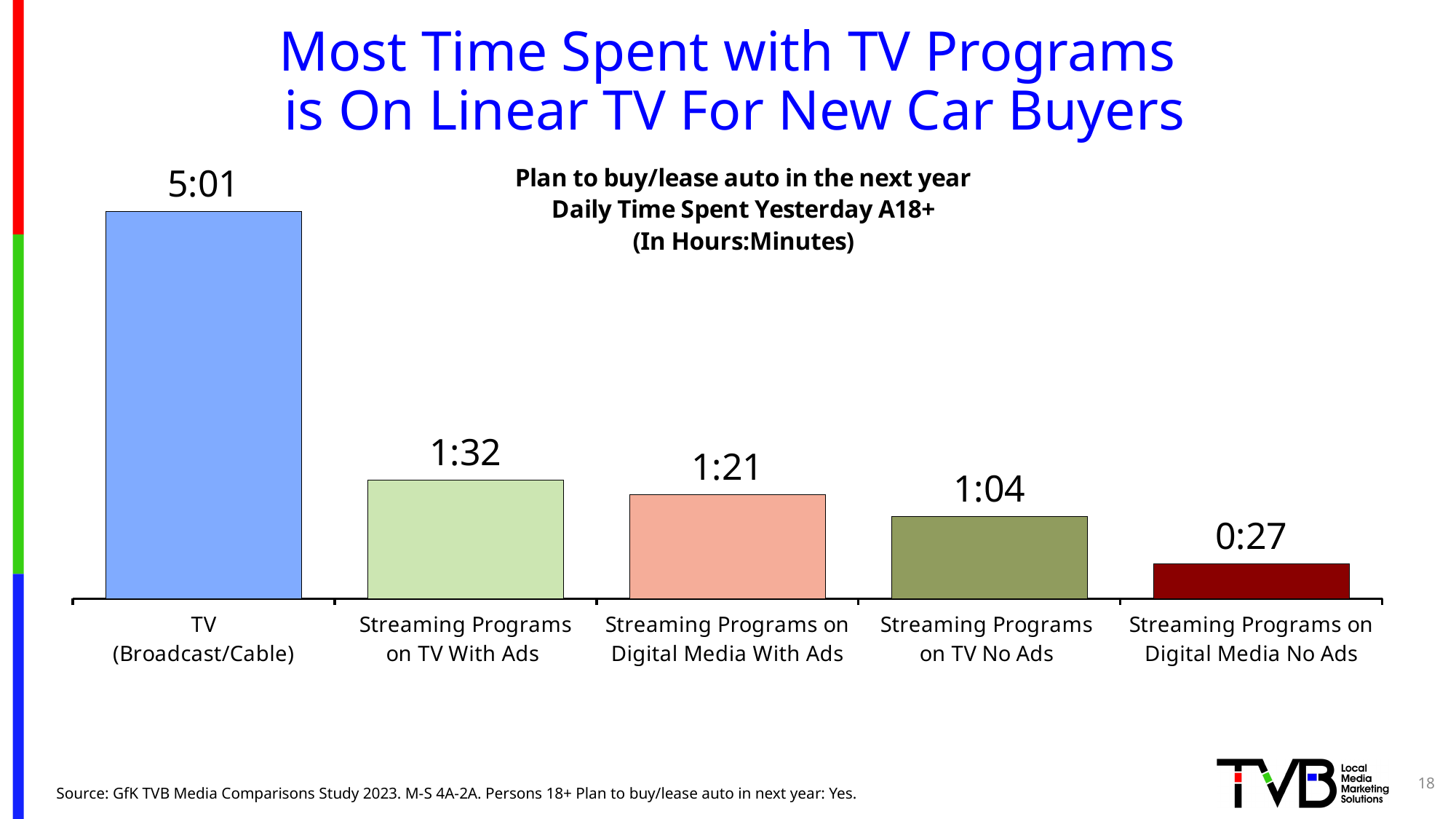
How many categories are shown in the chart? 5 What is the daily time spent with Streaming Programs on TV No Ads? 1:04 What is the daily time spent with TV (Broadcast/Cable)? 5:01 Which category has the lowest daily time spent? Streaming Programs on Digital Media No Ads What type of chart is shown on the slide? Bar chart In what units are the chart values expressed, according to the chart title? Hours:Minutes Which category has the highest daily time spent? TV (Broadcast/Cable) What is the daily time spent with Streaming Programs on Digital Media No Ads? 0:27 What is the daily time spent with Streaming Programs on Digital Media With Ads? 1:21 Which has more daily time spent: Streaming Programs on TV With Ads or Streaming Programs on TV No Ads? Streaming Programs on TV With Ads Do the values rise or fall moving from left to right across the categories? Fall What is the daily time spent with Streaming Programs on TV With Ads? 1:32